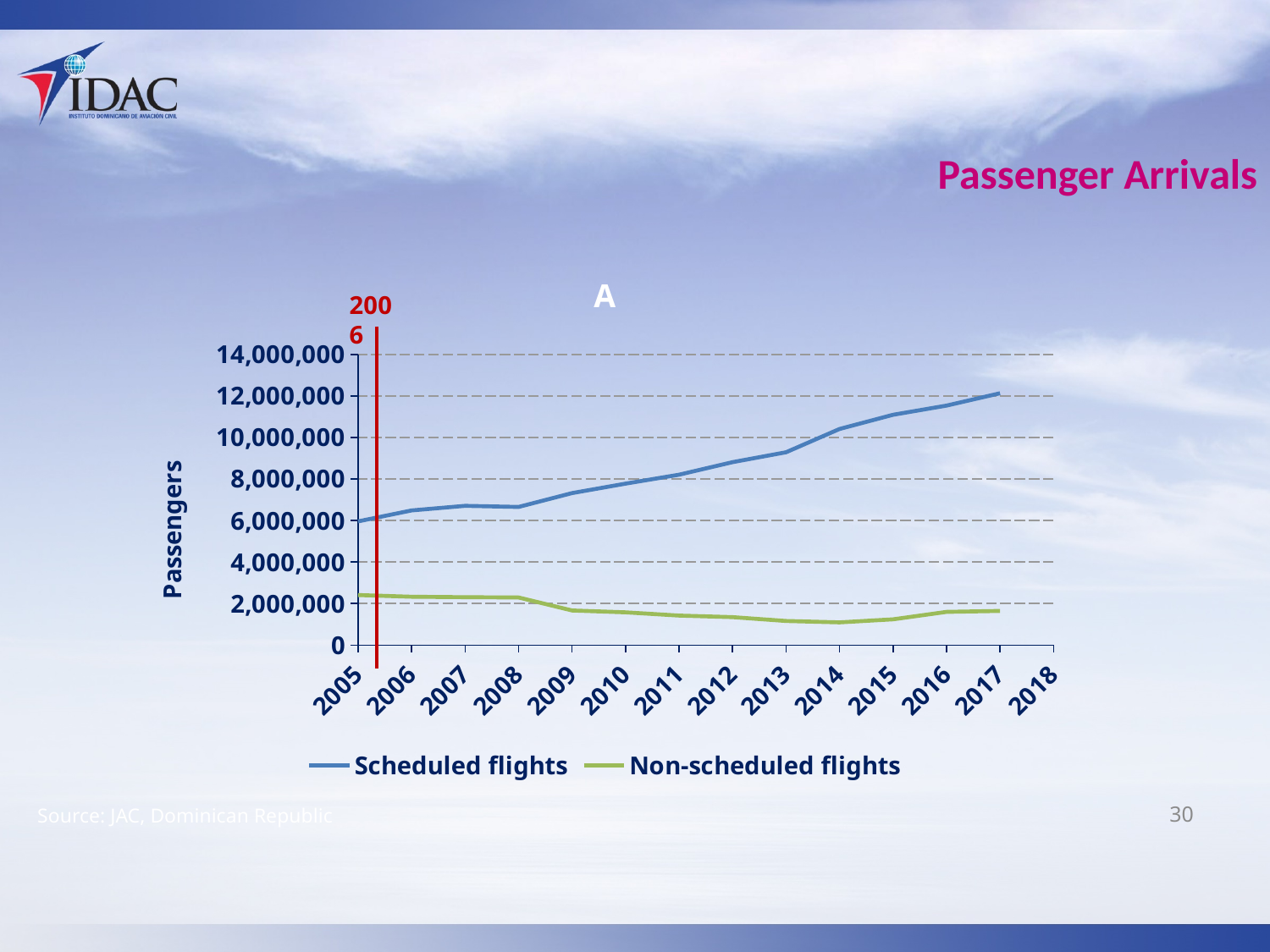
In which year is the value for Scheduled flights highest? 2017 In which year is the value for Non-scheduled flights lowest? 2014 How many series does the legend list? 2 In which year is the value for Scheduled flights lowest? 2005 What is the title of the slide's chart? A Do the values for Scheduled flights rise or fall from 2005 to 2017? Rise What are the two series named in the legend? Scheduled flights and Non-scheduled flights Which series has the larger value in 2017, Scheduled flights or Non-scheduled flights? Scheduled flights What kind of chart is shown on the slide? Line chart Is the value for Non-scheduled flights in 2014 greater or less than 2,000,000? less Is the value for Scheduled flights in 2013 greater or less than 8,000,000? greater Is the value for Scheduled flights in 2016 greater or less than 10,000,000? greater